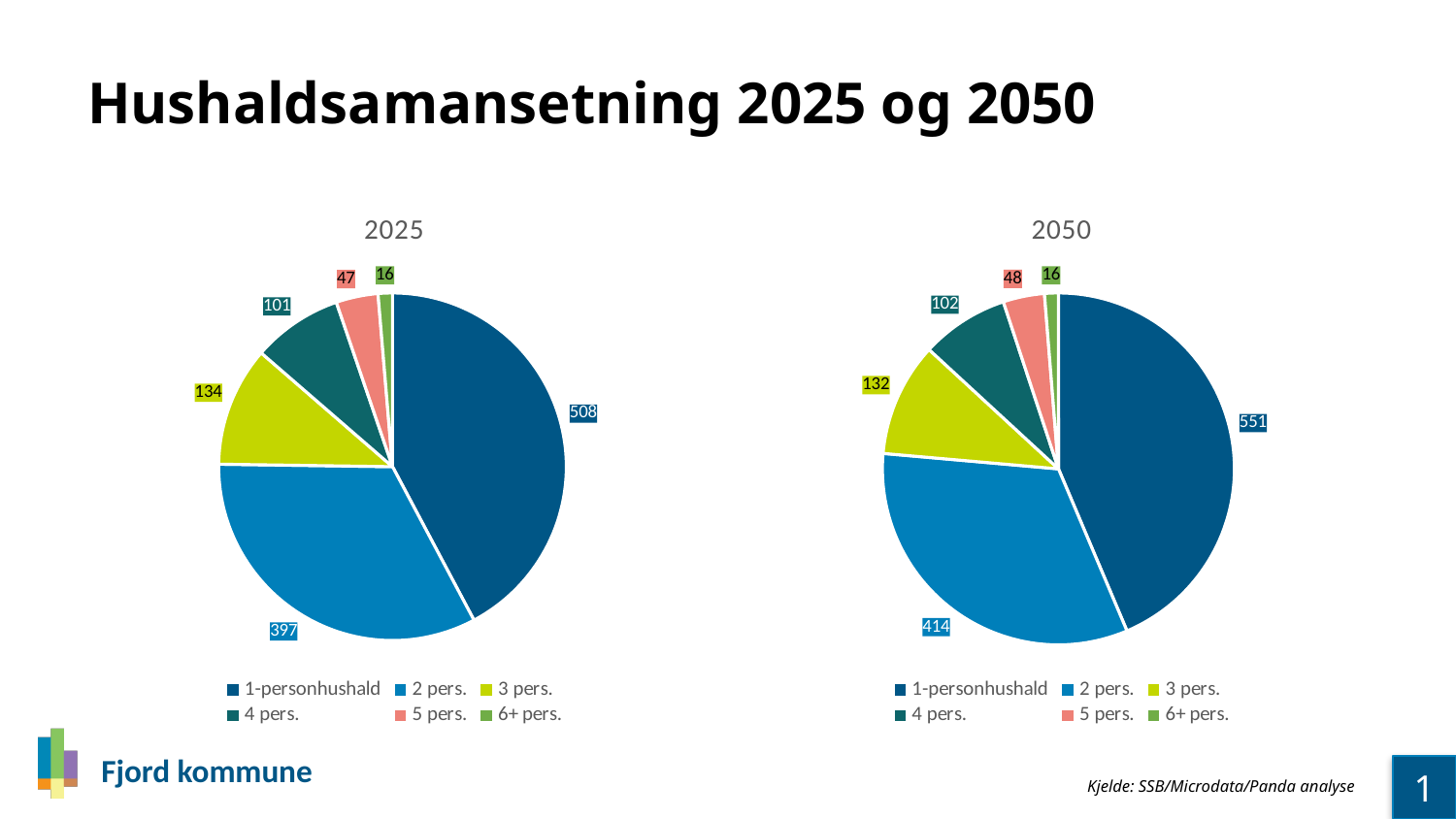
What is the difference between the 1-personhushald value in 2050 and in 2025? 43 What is the title of the slide? Hushaldsamansetning 2025 og 2050 In the 2050 pie chart, what is the value for 2 pers.? 414 In the 2025 pie chart, what is the value for 3 pers.? 134 How many categories does the 2050 pie chart show? 6 In the 2025 pie chart, which category has the smallest slice? 6+ pers. What type of chart is used for the 2025 data? Pie chart In the 2050 pie chart, which category has the largest slice? 1-personhushald In the 2050 pie chart, what is the value for 5 pers.? 48 In the 2025 pie chart, what is the value for 1-personhushald? 508 Which is larger: the 4 pers. value in 2025 or in 2050? 2050 In the 2025 pie chart, what is the difference between the 2 pers. and 3 pers. values? 263